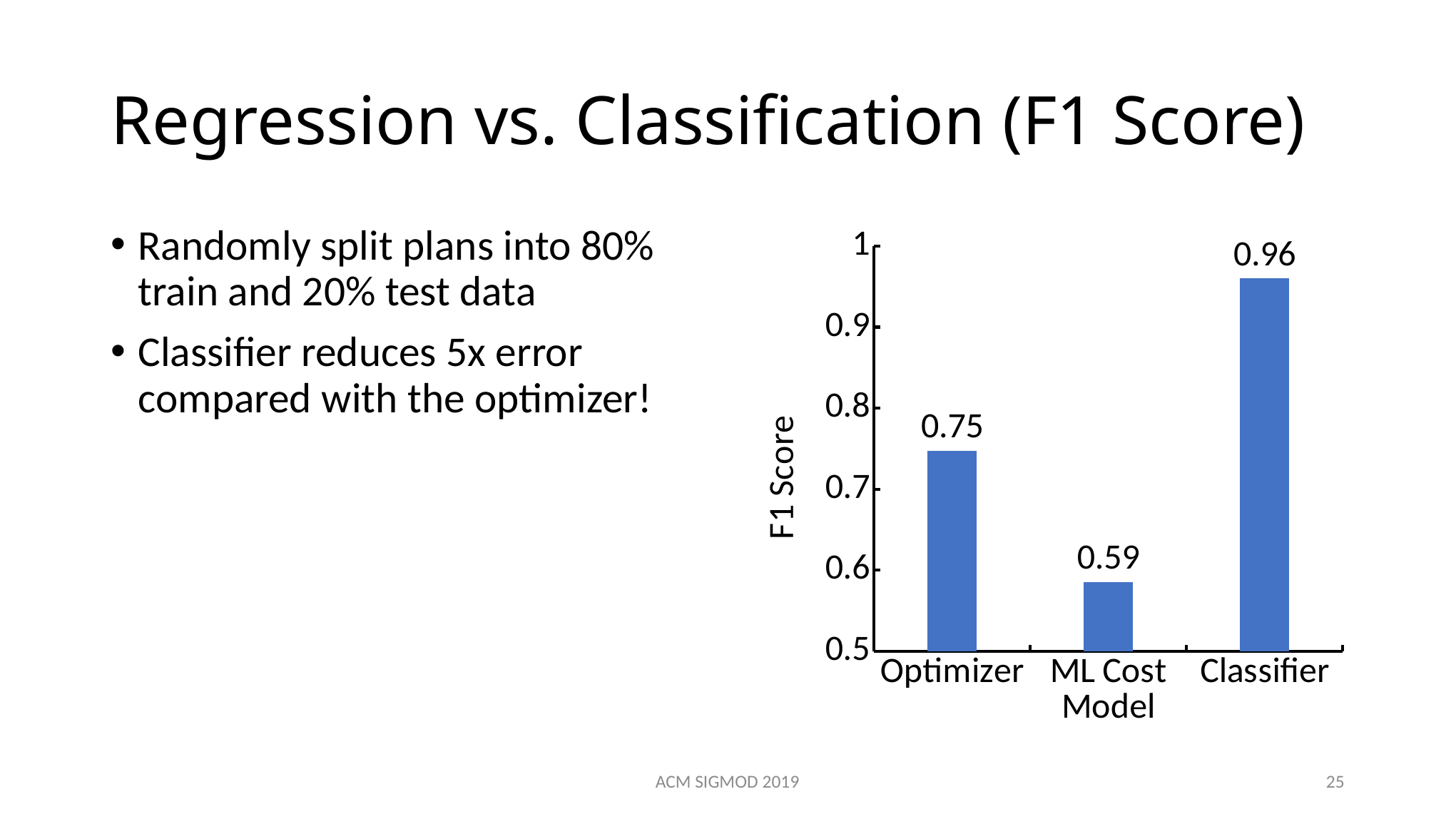
What is the difference in F1 Score between Classifier and Optimizer? 0.21 How many categories are shown on the x axis of the chart? 3 Which category has the lowest F1 Score? ML Cost Model What is the label of the y axis of the chart? F1 Score Which category has the highest F1 Score? Classifier What is the F1 Score for Optimizer? 0.75 What is the F1 Score for Classifier? 0.96 Is the F1 Score for Classifier greater or less than 0.9? greater What kind of chart is shown on the slide? bar chart What is the difference in F1 Score between Optimizer and ML Cost Model? 0.16 Which has a higher F1 Score, Optimizer or ML Cost Model? Optimizer What is the F1 Score for ML Cost Model? 0.59